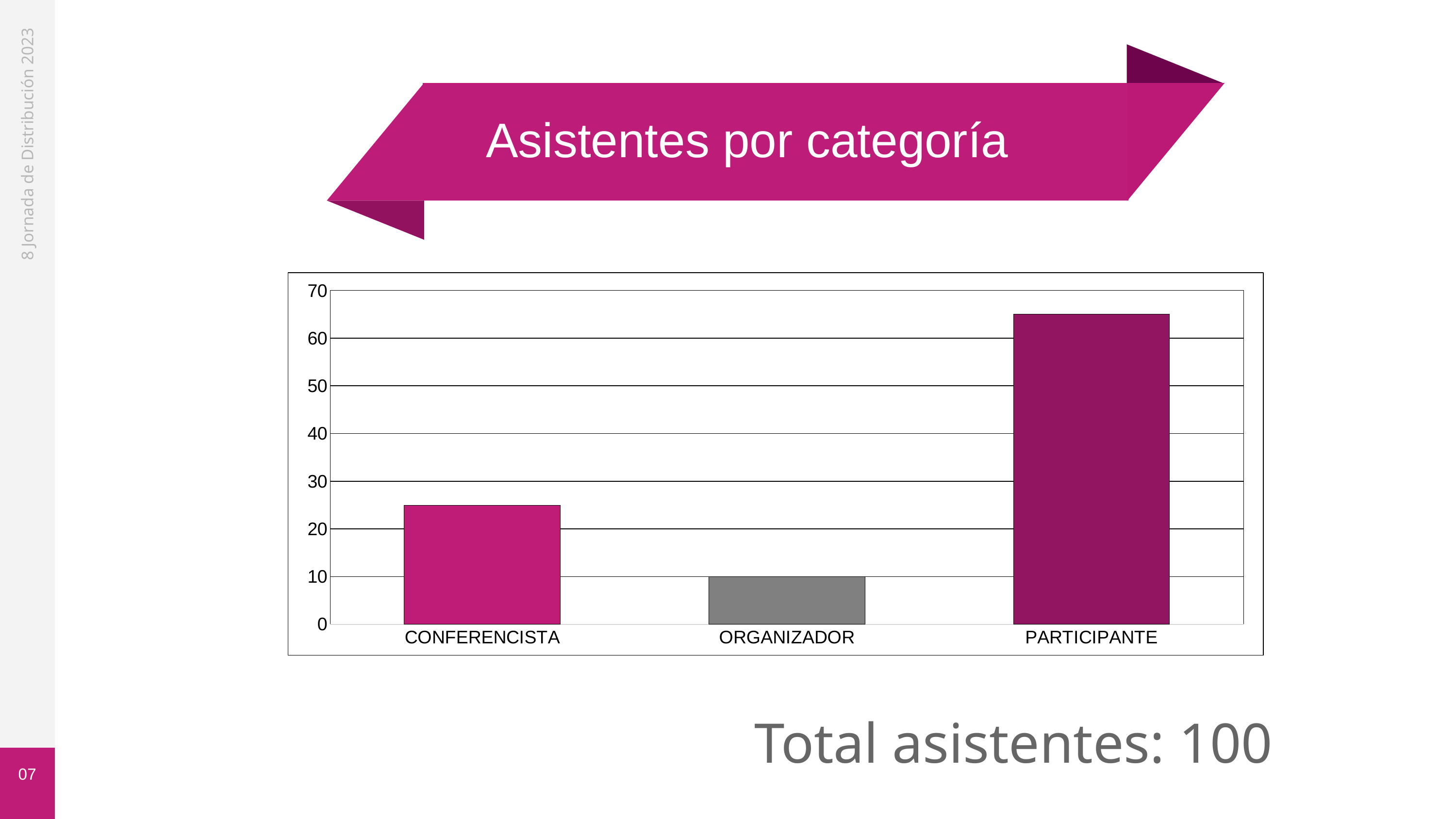
Which category has the lowest value in the chart? ORGANIZADOR Which is larger, the value for CONFERENCISTA or the value for ORGANIZADOR? CONFERENCISTA Which category has the highest value in the chart? PARTICIPANTE What is the title shown above the chart? Asistentes por categoría What kind of chart is shown on the slide? bar chart Is the value for PARTICIPANTE greater or less than 70? less Is the value for CONFERENCISTA greater or less than 30? less How many categories are shown in the chart? 3 What is the highest value shown on the vertical axis of the chart? 70 Is the value for PARTICIPANTE greater or less than 60? greater What is the value for ORGANIZADOR? 10